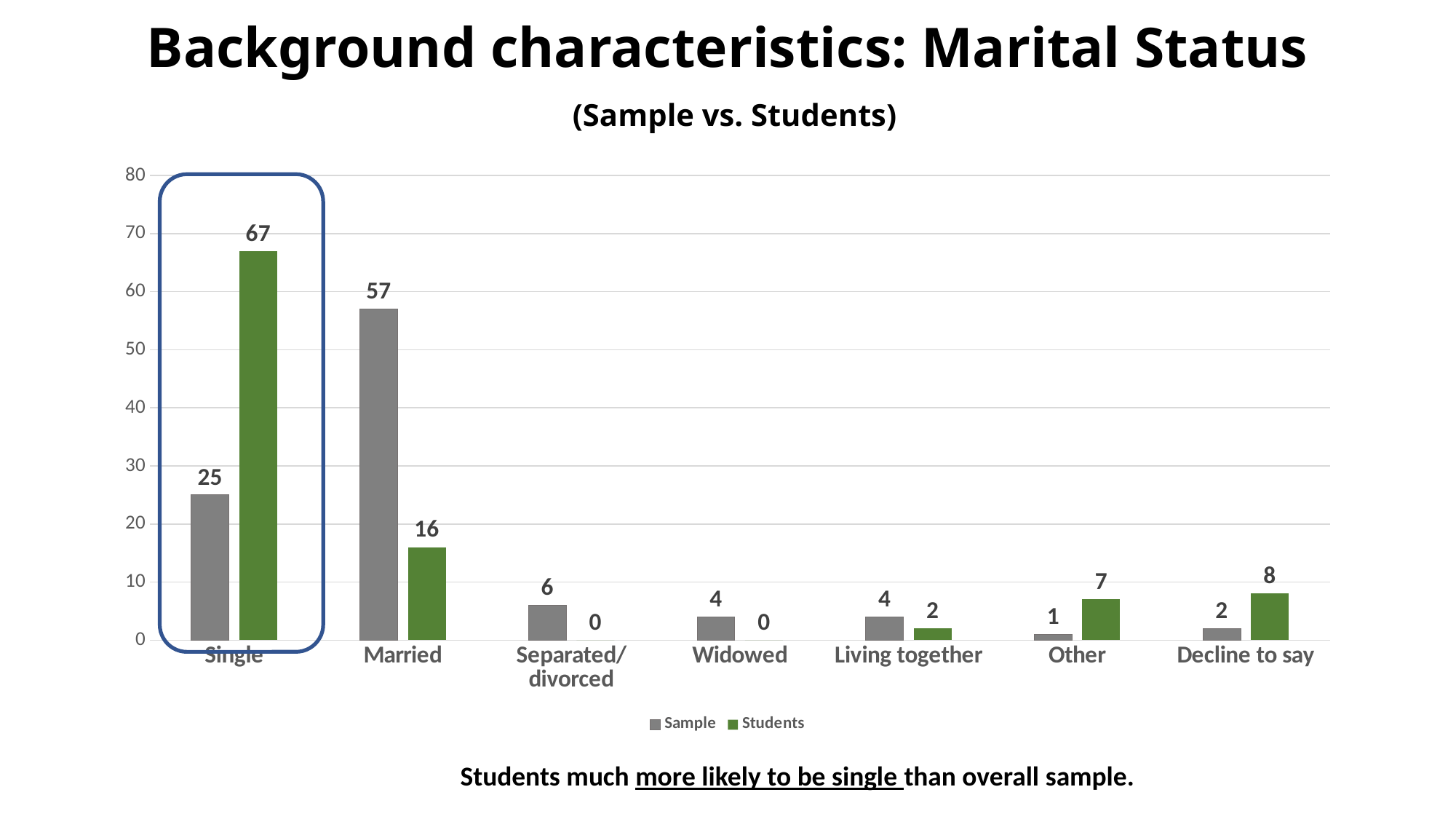
Which category has the highest Sample value? Married Which category is highlighted with a blue rounded outline? Single Which is larger for Married, the Sample value or the Students value? Sample What is the Students value for Decline to say? 8 How many marital status categories are shown on the x axis? 7 What is the difference between the Students and Sample values for Single? 42 Which category has the highest Students value? Single What is the Sample value for Married? 57 What kind of chart is shown on the slide? Bar chart How many series does the legend list? 2 Which category has the lowest Sample value? Other What is the Students value for Single? 67